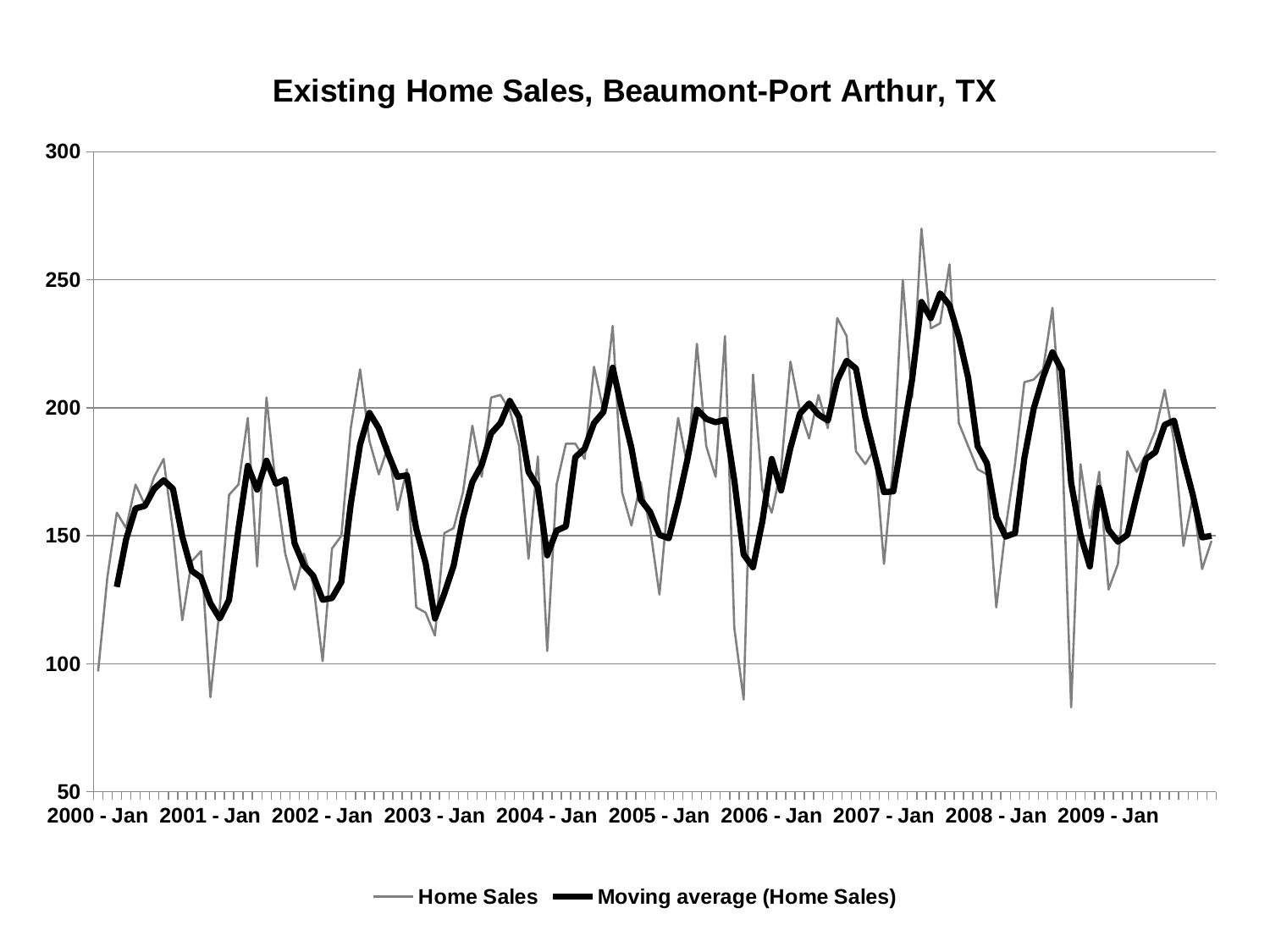
How many series does the legend list? 2 Is the Home Sales value at 2006 - Jan greater or less than 100? greater Is the highest value of the Moving average (Home Sales) series greater or less than 200? greater In which year does the Home Sales series reach its highest peak? 2007 Which series is drawn with the thicker black line? Moving average (Home Sales) Which is higher, the Home Sales peak in 2007 or the Home Sales peak in 2004? the peak in 2007 Is the Home Sales value at 2003 - Jan greater or less than 150? less How many year labels are shown on the x axis? 10 What is the title of the chart? Existing Home Sales, Beaumont-Port Arthur, TX What kind of chart is shown on the slide? line chart